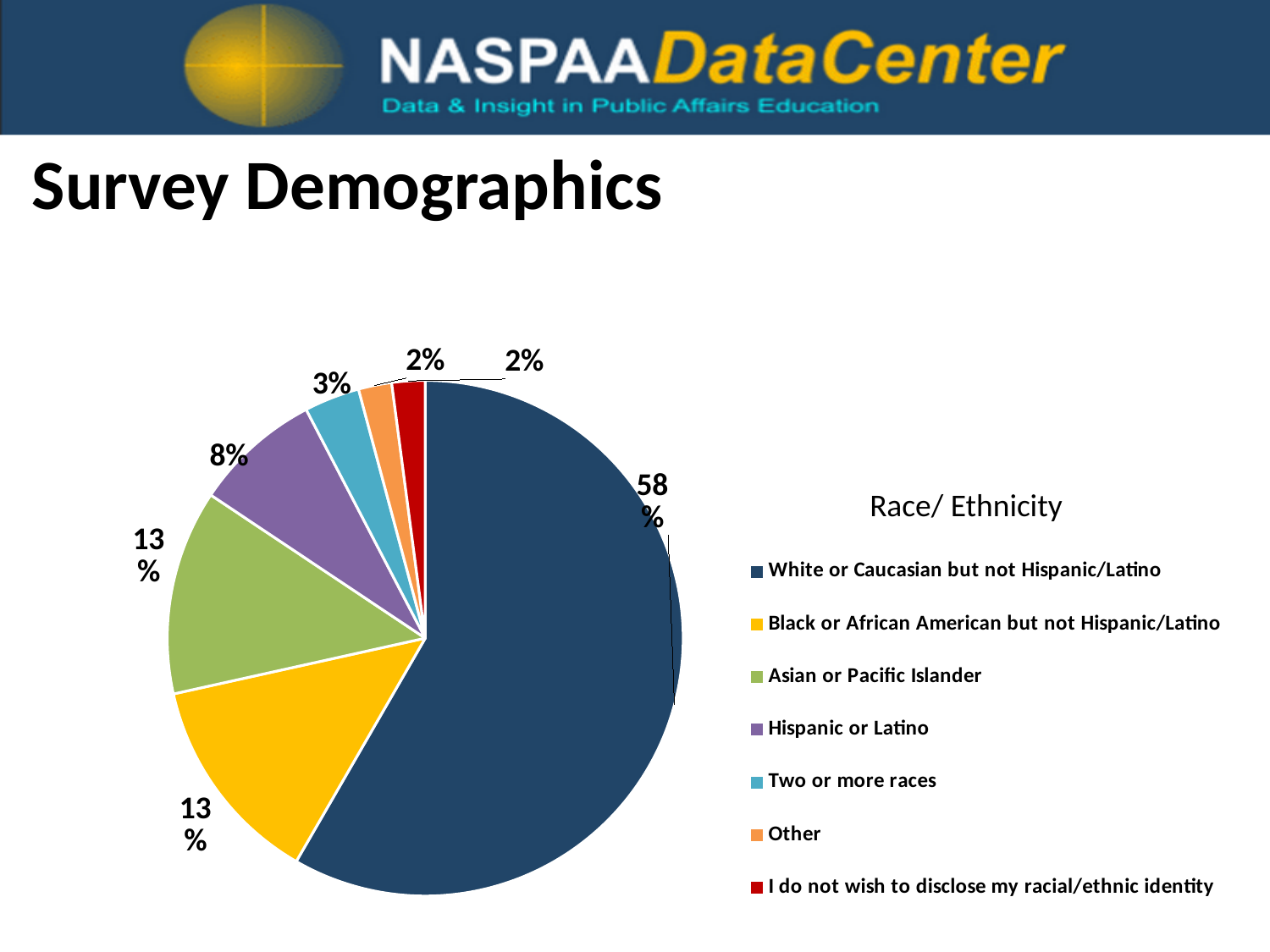
What percentage is shown for Other? 2% What percentage is shown for Hispanic or Latino? 8% How many categories does the legend list? 7 What percentage is shown for Two or more races? 3% What is the difference between the White or Caucasian but not Hispanic/Latino share and the Black or African American but not Hispanic/Latino share? 45% Which is larger, the Hispanic or Latino share or the Two or more races share? Hispanic or Latino What share of the pie is White or Caucasian but not Hispanic/Latino? 58% What type of chart is shown on the slide? pie chart What is the title of the chart? Race/ Ethnicity What percentage is shown for Asian or Pacific Islander? 13% What colour is the slice for I do not wish to disclose my racial/ethnic identity? red Which category has the largest slice of the pie? White or Caucasian but not Hispanic/Latino